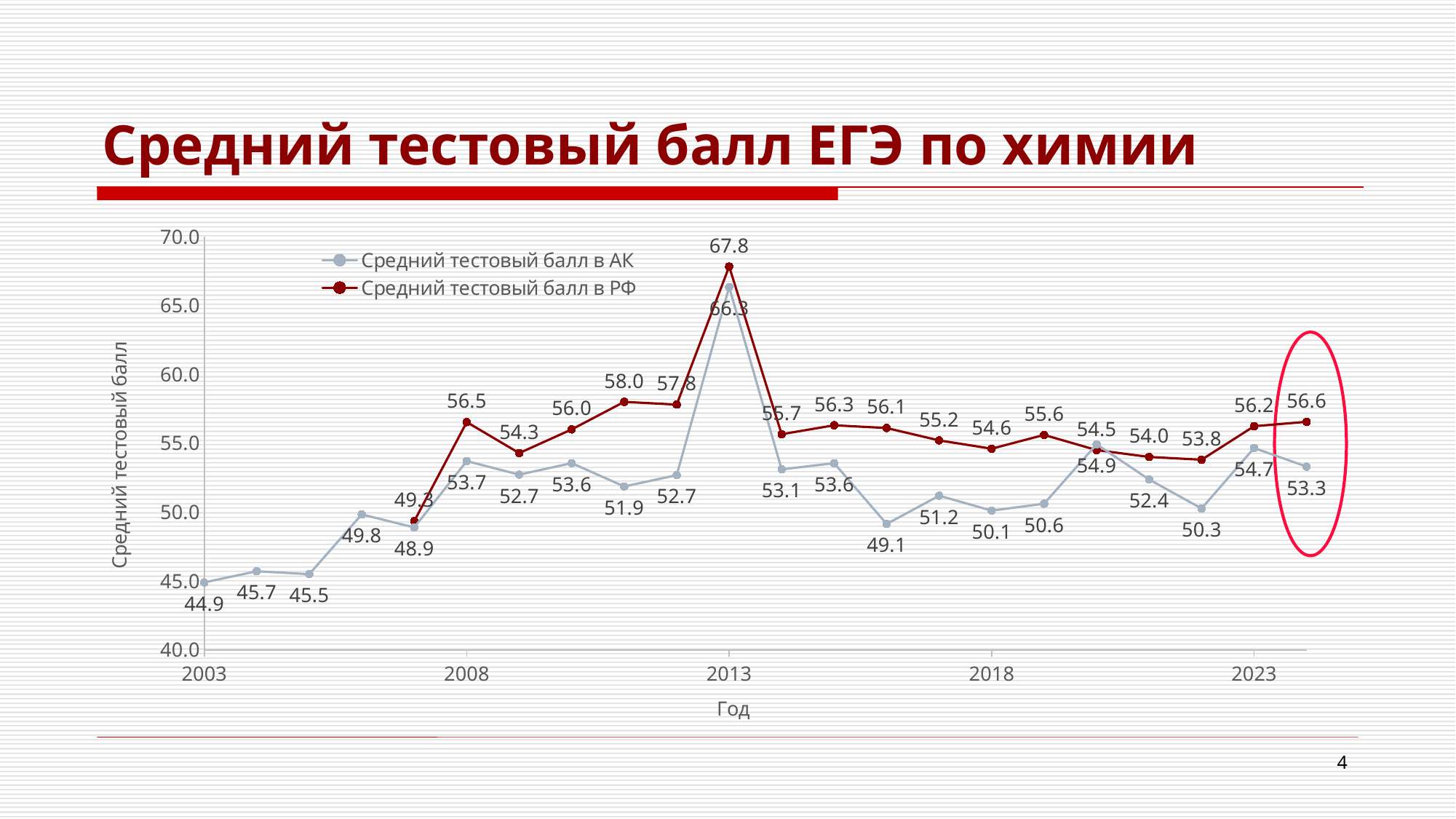
What is the value of 'Средний тестовый балл в АК' in 2008? 53.7 In 2023, which series has the larger value: 'Средний тестовый балл в АК' or 'Средний тестовый балл в РФ'? Средний тестовый балл в РФ What is the title of the x axis? Год What kind of chart is shown on the slide? line chart In which year is 'Средний тестовый балл в АК' lowest? 2003 What is the value of 'Средний тестовый балл в РФ' in 2013? 67.8 In which year is 'Средний тестовый балл в АК' highest? 2013 What is the value of 'Средний тестовый балл в АК' in 2003? 44.9 What is the value of 'Средний тестовый балл в РФ' in 2018? 54.6 What is the value of 'Средний тестовый балл в АК' in 2013? 66.3 How many series does the legend list? 2 What is the difference between 'Средний тестовый балл в РФ' and 'Средний тестовый балл в АК' in 2013? 1.5